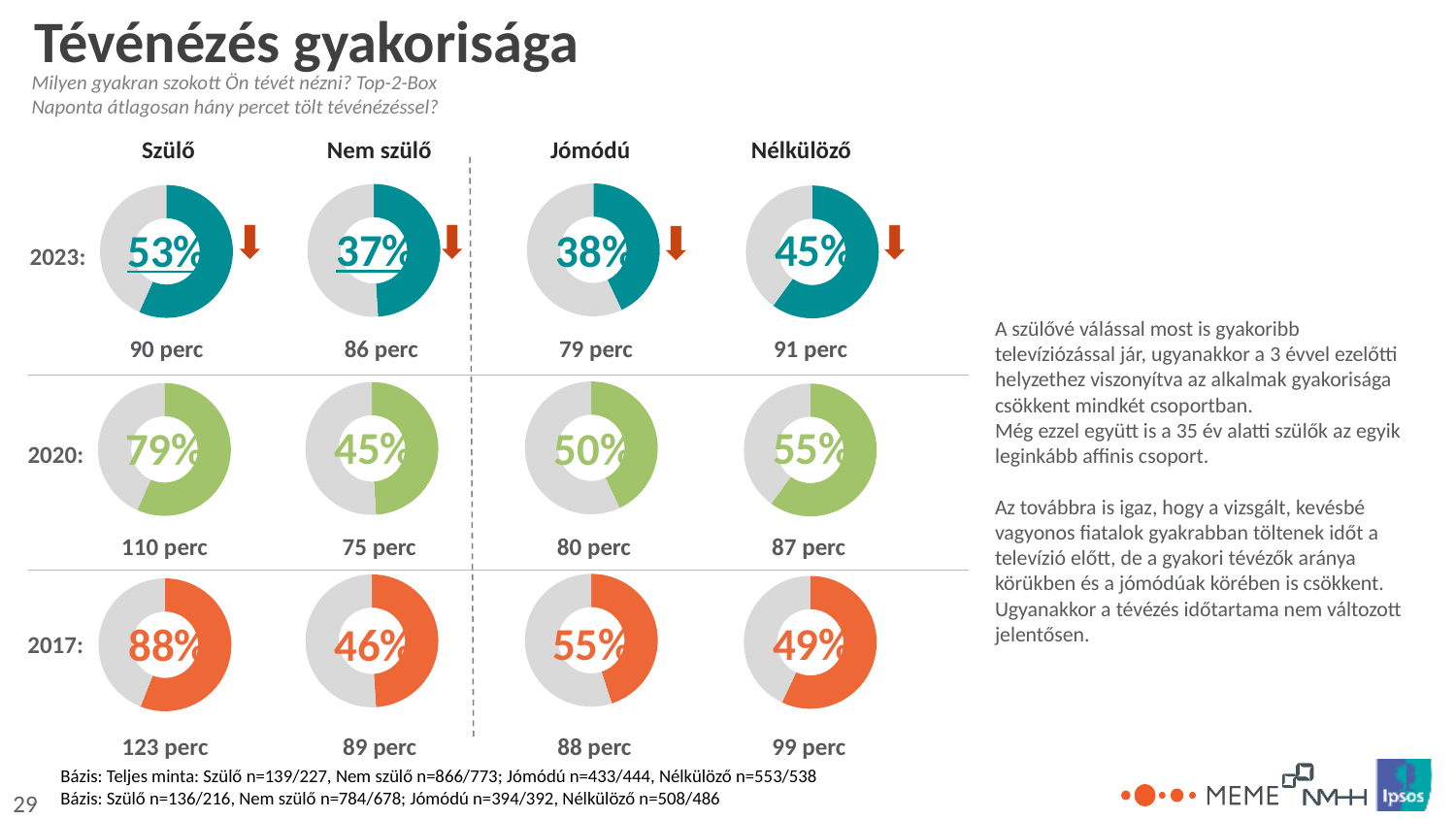
In the 2017 row, what percentage is shown in the donut chart for Jómódú? 55% What type of chart is used to display the percentages on the slide? donut (pie) chart In the 2023 row, what percentage is shown in the donut chart for Szülő? 53% In the 2020 row, which is larger: the percentage for Jómódú or for Nélkülöző? Nélkülöző Looking at the Szülő column from 2017 to 2023, do the percentages rise or fall? fall In the 2023 row, what value in minutes is printed below the Nélkülöző donut chart? 91 perc What is the difference between the Szülő percentages shown for 2017 and 2023? 35 percentage points How many donut charts are shown on the slide? 12 In the 2017 row, which group's donut chart shows the highest percentage? Szülő What colour are the donut charts in the 2020 row? green In the 2023 row, which group's donut chart shows the lowest percentage? Nem szülő In the 2020 row, what percentage is shown in the donut chart for Nem szülő? 45%